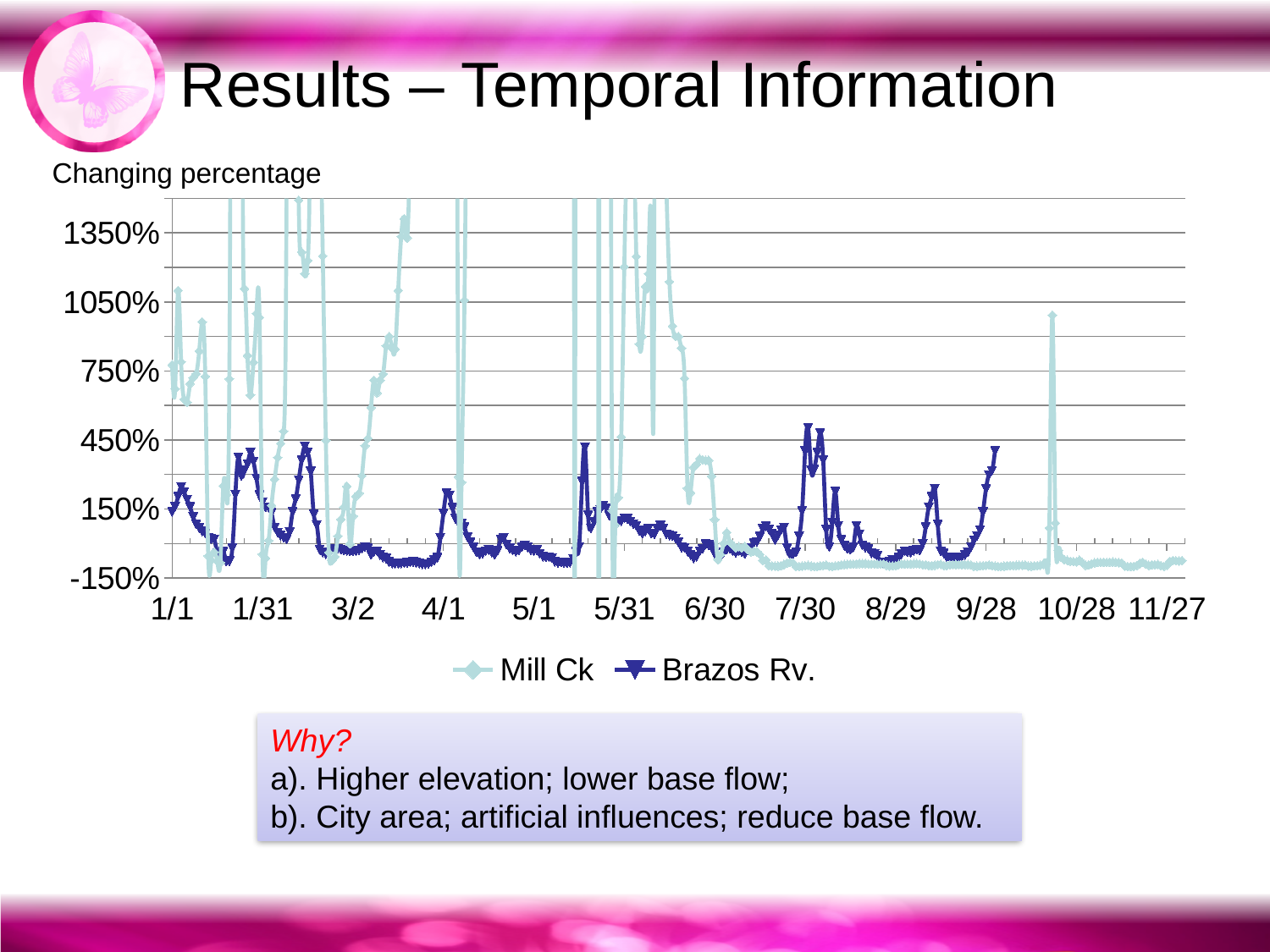
What is the lowest value labelled on the y axis? -150% What kind of chart is shown on the slide? Line chart How many series does the legend list? 2 Does the Brazos Rv. series ever rise above 750%? No Is the Mill Ck spike shortly before 10/28 greater or less than 750%? greater Which series reaches higher peak values over the year, Mill Ck or Brazos Rv.? Mill Ck What is the highest value labelled on the y axis? 1350% Is the Mill Ck value around 11/27 greater or less than 150%? less How many date labels are shown along the x axis? 12 What is the title shown above the chart? Changing percentage